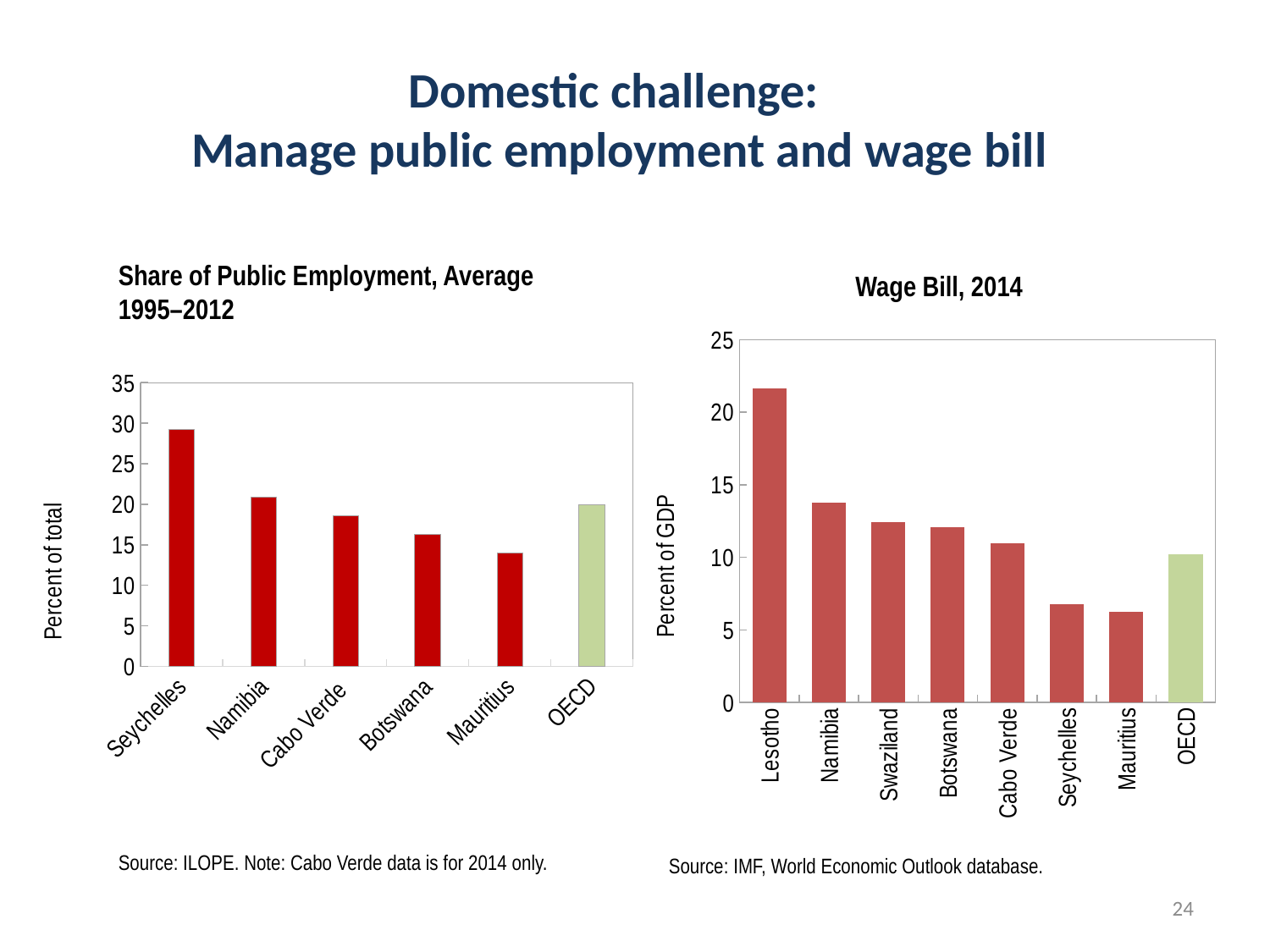
In the Wage Bill, 2014 chart, which category has the highest value? Lesotho In the Share of Public Employment chart, which category has the highest value? Seychelles How many categories are shown in the Wage Bill, 2014 chart? 8 What kind of chart is the Wage Bill, 2014 chart? bar chart How many categories are shown in the Share of Public Employment chart? 6 In the Share of Public Employment chart, which category has the lowest value? Mauritius In the Share of Public Employment chart, is the value for Mauritius greater or less than 15? less In the Share of Public Employment chart, is the value for Seychelles greater or less than 25? greater In the Share of Public Employment chart, which is larger, Namibia or Botswana? Namibia In the Wage Bill, 2014 chart, is the value for Lesotho greater or less than 20? greater What is the y-axis label of the Wage Bill, 2014 chart? Percent of GDP